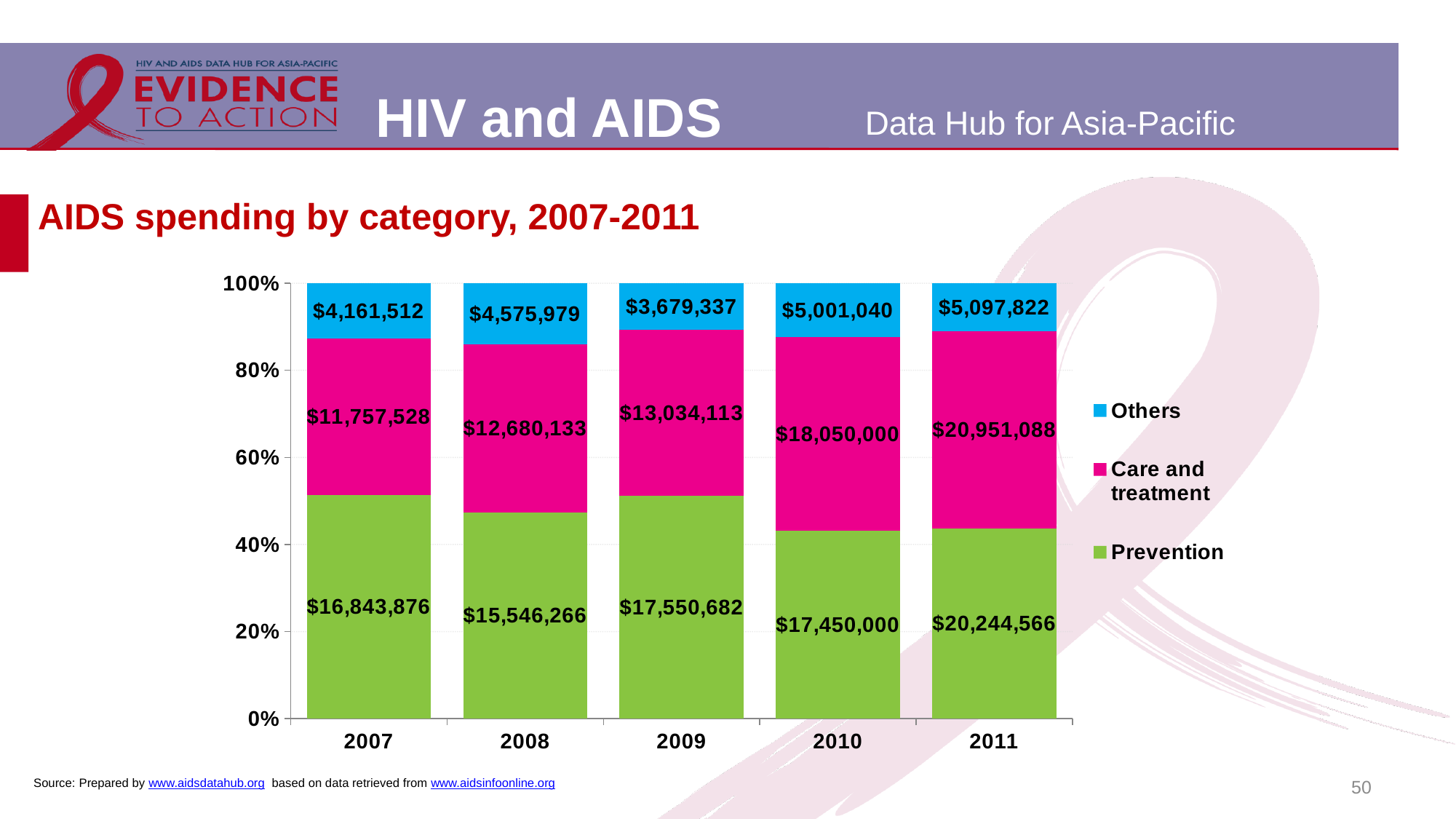
Is the Prevention share of spending in 2010 greater or less than 50%? less What kind of chart is shown on the slide? Stacked bar chart What was the Care and treatment spending in 2010? $18,050,000 How many series does the legend list? 3 Which was larger in 2011, Prevention spending or Care and treatment spending? Care and treatment How many years are shown on the x axis? 5 How much more was spent on Care and treatment in 2011 than in 2010? $2,901,088 In which year was Care and treatment spending the highest? 2011 What was the Others spending in 2008? $4,575,979 What was the total AIDS spending across all three categories in 2007? $32,762,916 What was the Prevention spending in 2009? $17,550,682 In which year was Others spending the lowest? 2009